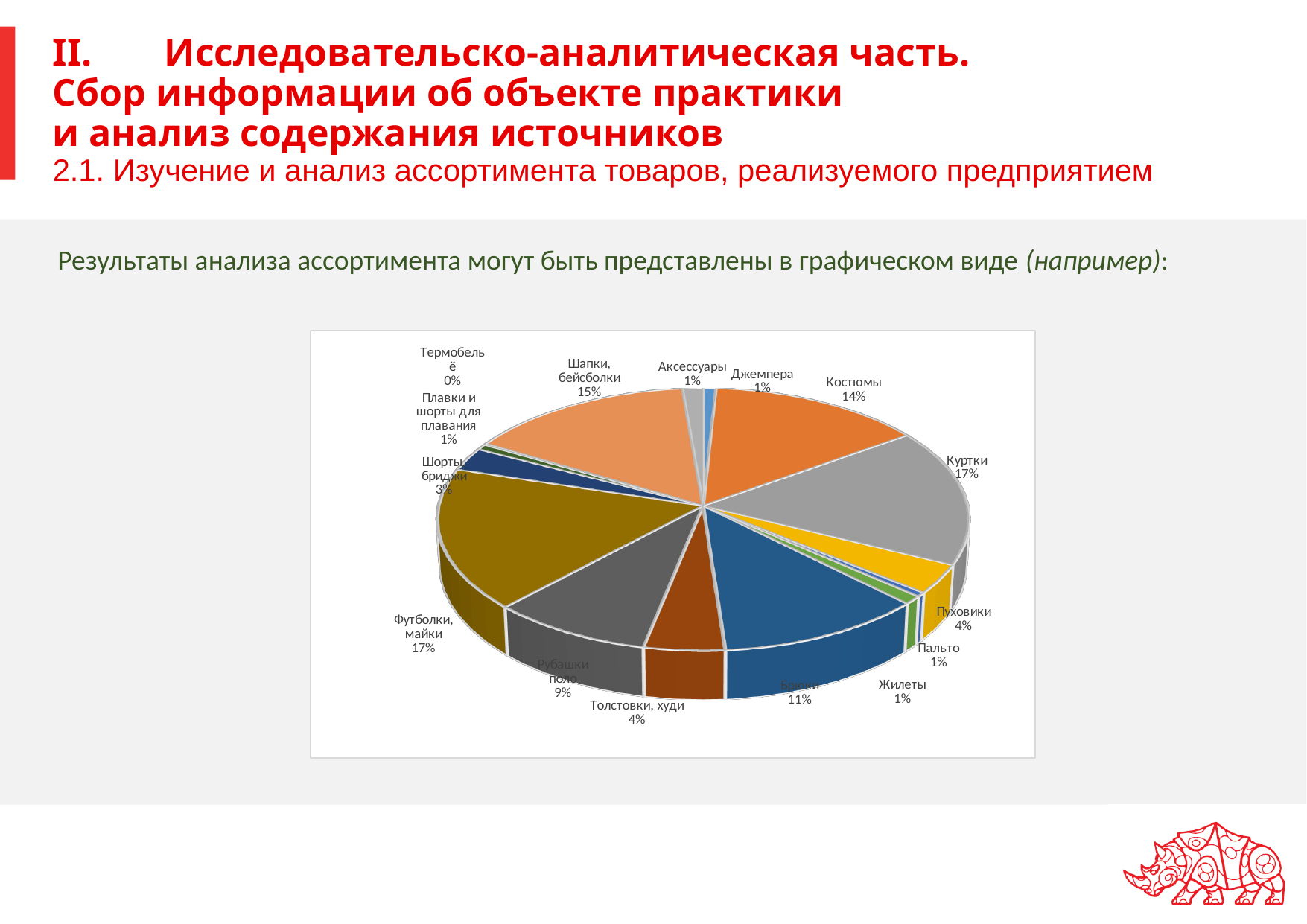
What share of the pie chart is Костюмы? 14% How many categories are shown in the pie chart? 15 Which has a larger share, Шапки, бейсболки or Костюмы? Шапки, бейсболки What kind of chart is shown on the slide? pie chart What share of the pie chart is Пуховики? 4% What is the difference between the shares of Костюмы and Брюки? 3% What share of the pie chart is Рубашки поло? 9% What share of the pie chart is Куртки? 17% Which category has the smallest share in the pie chart? Термобельё What share of the pie chart is Шапки, бейсболки? 15% What is the combined share of Толстовки, худи and Шорты, бриджи? 7% What share of the pie chart is Брюки? 11%